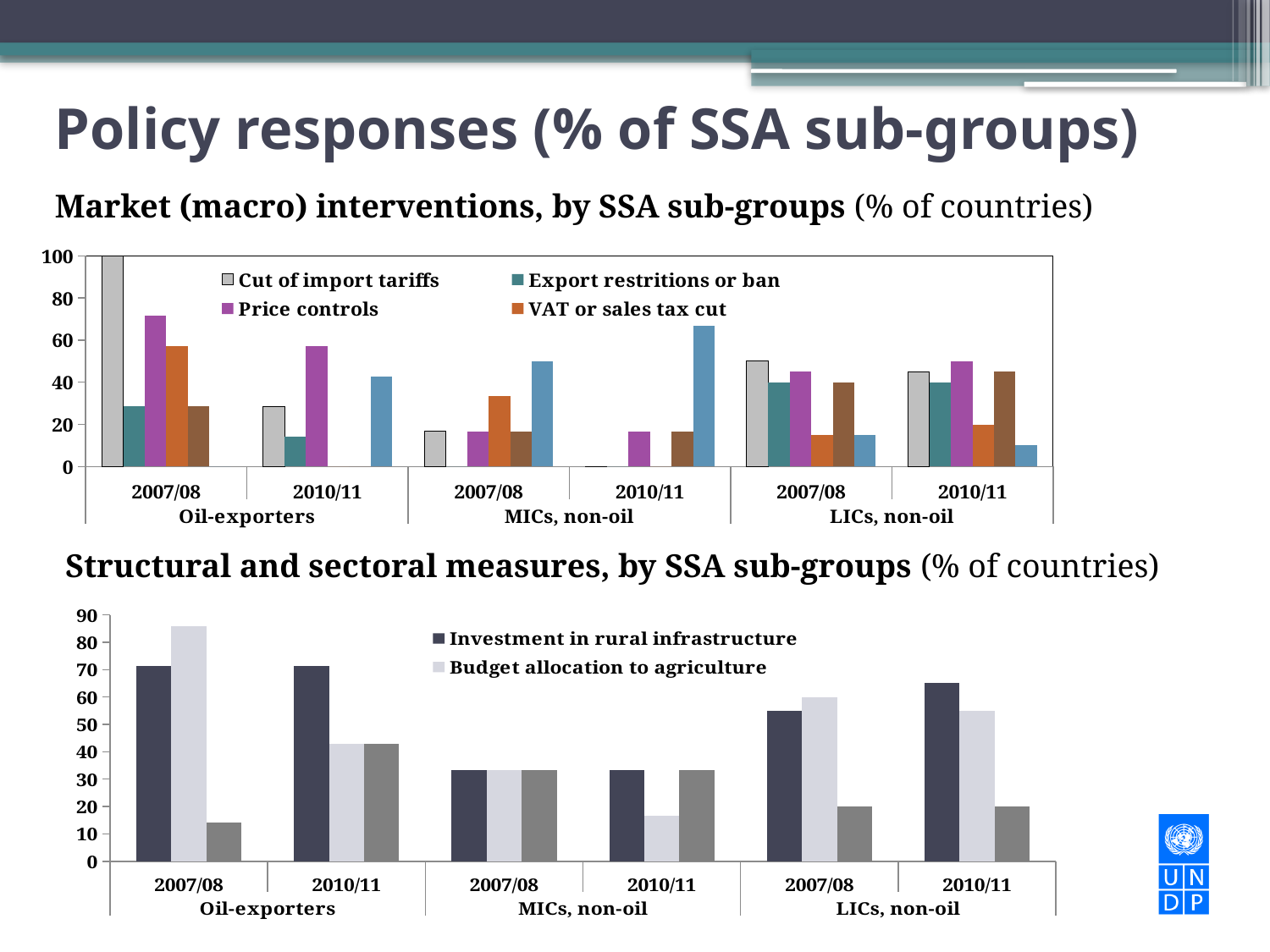
In the top chart, 'Market (macro) interventions', is the value for Price controls for Oil-exporters in 2010/11 greater or less than 40? greater In the top chart, 'Market (macro) interventions', is the value for Cut of import tariffs for Oil-exporters in 2007/08 greater or less than 80? greater What kind of chart is the top chart, 'Market (macro) interventions, by SSA sub-groups'? Bar chart In the bottom chart, 'Structural and sectoral measures', how many SSA sub-groups are shown on the x axis? 3 In the bottom chart, 'Structural and sectoral measures', which is larger for LICs, non-oil in 2010/11: Investment in rural infrastructure or Budget allocation to agriculture? Investment in rural infrastructure In the top chart, 'Market (macro) interventions', which is larger for MICs, non-oil in 2007/08: Cut of import tariffs or VAT or sales tax cut? VAT or sales tax cut In the bottom chart, 'Structural and sectoral measures', is the value for Budget allocation to agriculture for Oil-exporters in 2007/08 greater or less than 80? greater In the top chart, 'Market (macro) interventions', how many series does the legend list? 4 In the bottom chart, 'Structural and sectoral measures', which is larger for Oil-exporters in 2007/08: Investment in rural infrastructure or Budget allocation to agriculture? Budget allocation to agriculture In the bottom chart, 'Structural and sectoral measures', how many series does the legend list? 2